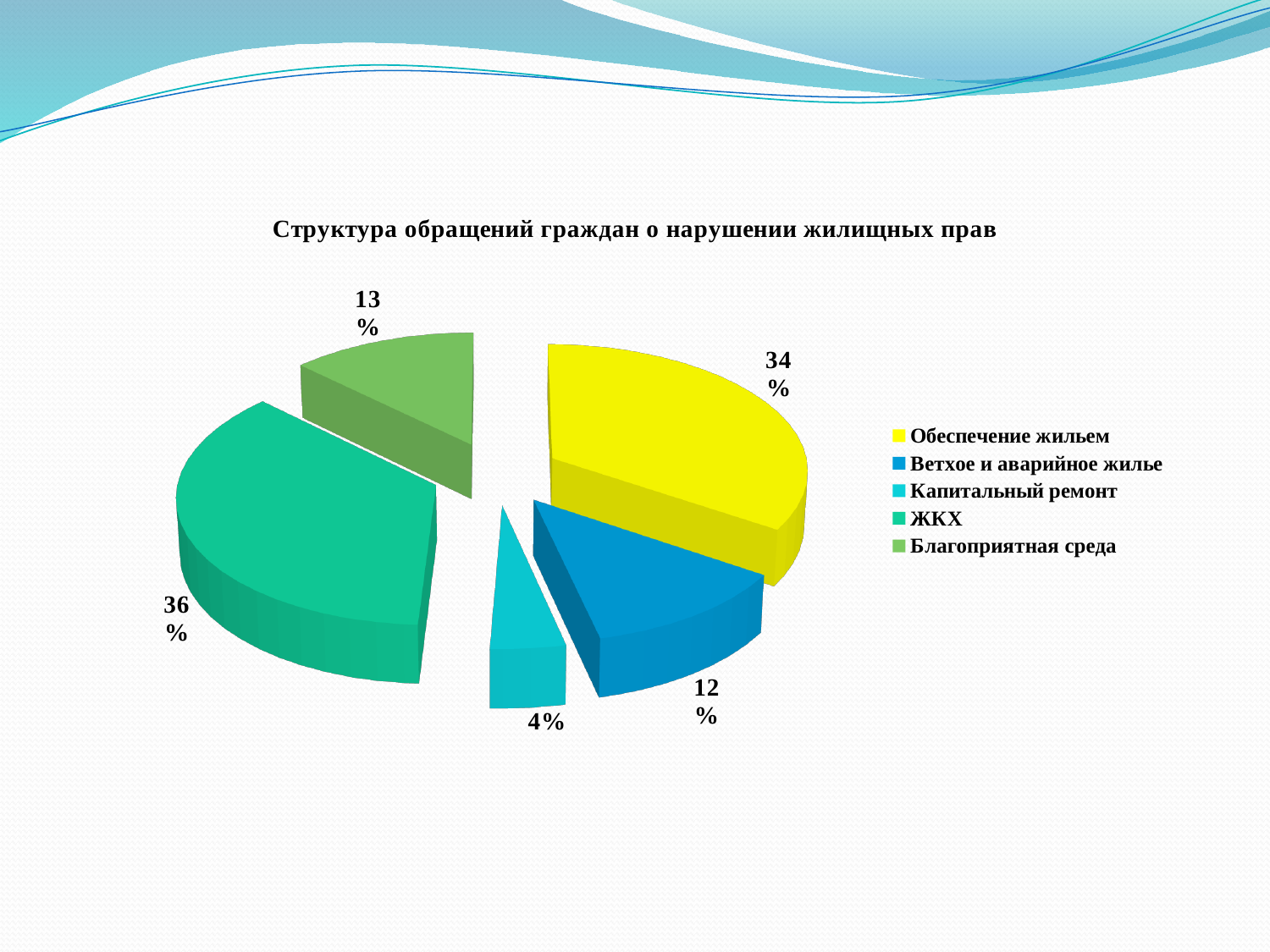
How many categories does the pie chart show? 5 What is the title of the chart? Структура обращений граждан о нарушении жилищных прав What share of the pie does Обеспечение жильем have? 34% What kind of chart is shown on the slide? Pie chart What share of the pie does Благоприятная среда have? 13% What share of the pie does Ветхое и аварийное жилье have? 12% Which is larger, the share for Ветхое и аварийное жилье or the share for Благоприятная среда? Благоприятная среда Which category has the smallest share of the pie? Капитальный ремонт What share of the pie does Капитальный ремонт have? 4% What is the difference in percentage points between ЖКХ and Обеспечение жильем? 2 What share of the pie does ЖКХ have? 36% Which category has the largest share of the pie? ЖКХ